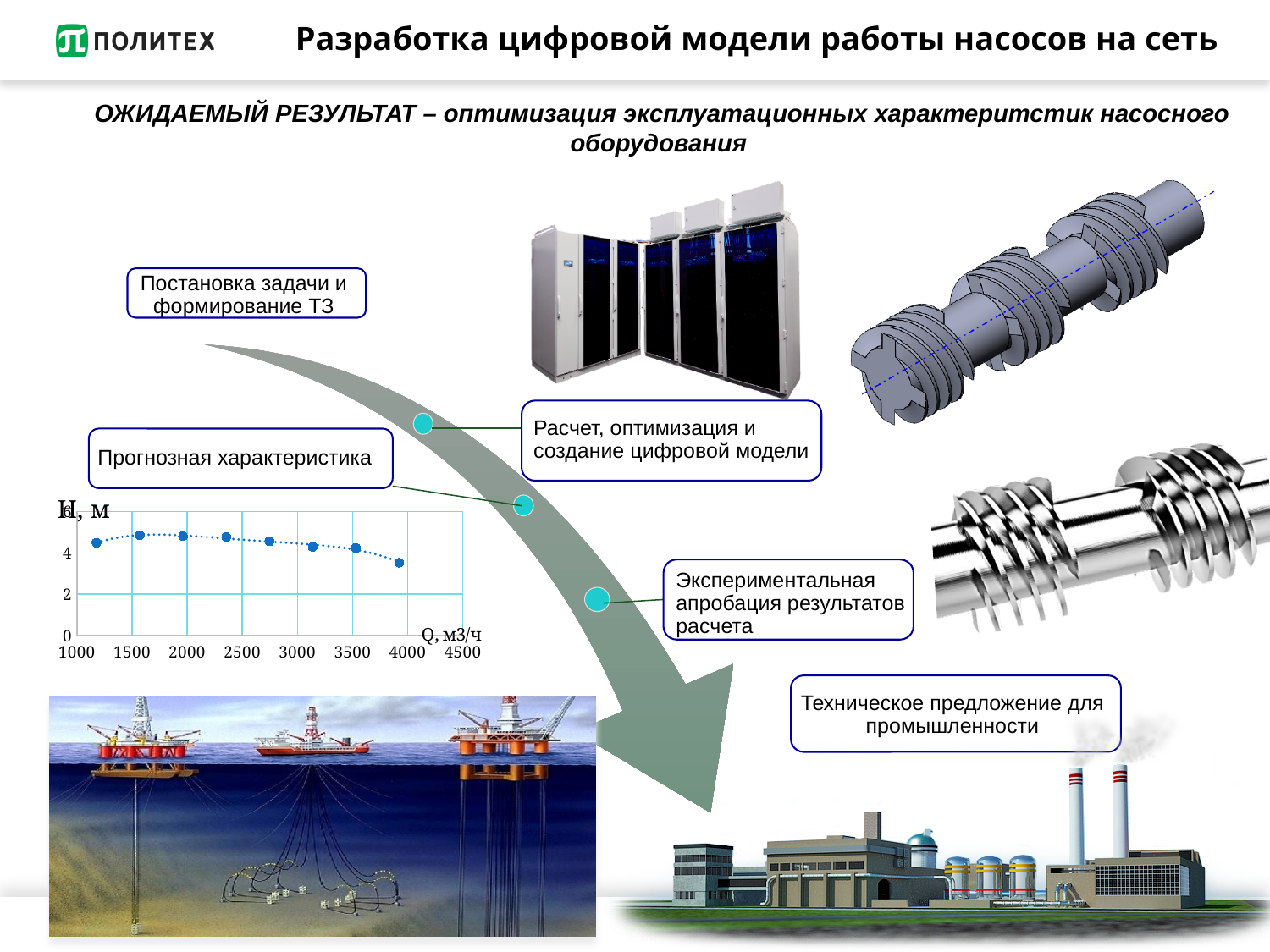
What is the label of the vertical axis of the chart? H, м Is the value of the rightmost point (near Q = 3900) greater or less than 4? less Do the H values rise or fall toward the right end of the x axis? fall Is the value of the leftmost point (near Q = 1200) greater or less than 4? greater Which is larger: the H value of the point near Q = 1200 or the point near Q = 3900? the point near Q = 1200 What kind of chart is shown on the slide? scatter chart How many data points are plotted on the chart? 8 What is the label of the horizontal axis of the chart? Q, м3/ч Is the value of the point near Q = 2750 greater or less than 2? greater Which point has the lowest H value on the chart? the rightmost point, near Q = 3900 What is the highest tick value shown on the x axis? 4500